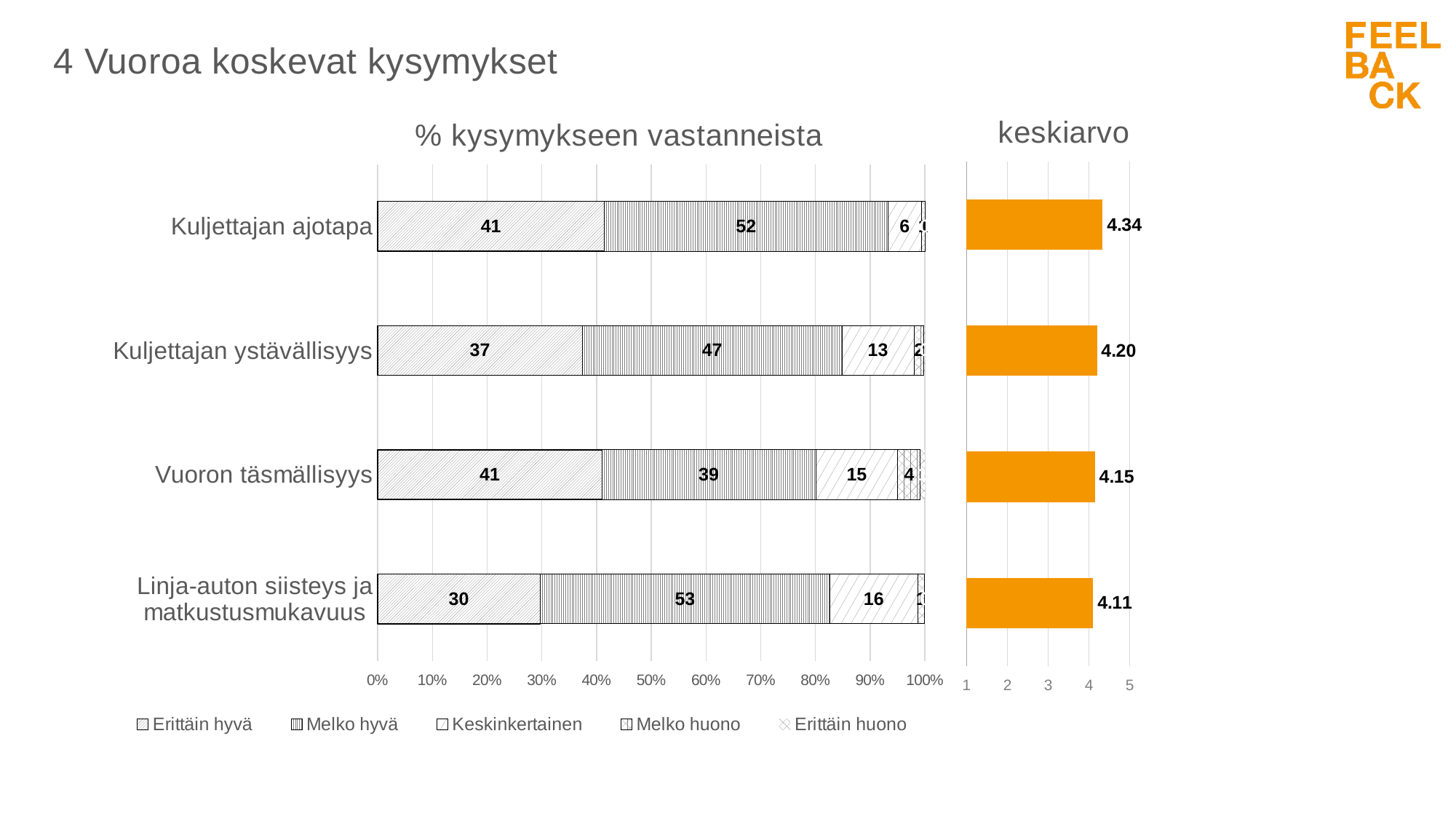
In the keskiarvo chart, what is the value for Kuljettajan ajotapa? 4.34 In the keskiarvo chart, which category has the highest value? Kuljettajan ajotapa In the % kysymykseen vastanneista chart, which category has the highest Melko hyvä value? Linja-auton siisteys ja matkustusmukavuus In the keskiarvo chart, what is the value for Linja-auton siisteys ja matkustusmukavuus? 4.11 In the % kysymykseen vastanneista chart, is the Erittäin hyvä value for Kuljettajan ajotapa larger or smaller than that for Linja-auton siisteys ja matkustusmukavuus? larger In the % kysymykseen vastanneista chart, what is the Erittäin hyvä value for Kuljettajan ystävällisyys? 37 In the % kysymykseen vastanneista chart, what is the Keskinkertainen value for Vuoron täsmällisyys? 15 What kind of chart is the keskiarvo chart? bar chart How many series does the legend of the % kysymykseen vastanneista chart list? 5 In the keskiarvo chart, which category has the lowest value? Linja-auton siisteys ja matkustusmukavuus In the % kysymykseen vastanneista chart, what is the Melko hyvä value for Linja-auton siisteys ja matkustusmukavuus? 53 In the keskiarvo chart, what is the difference between the values for Kuljettajan ajotapa and Vuoron täsmällisyys? 0.19